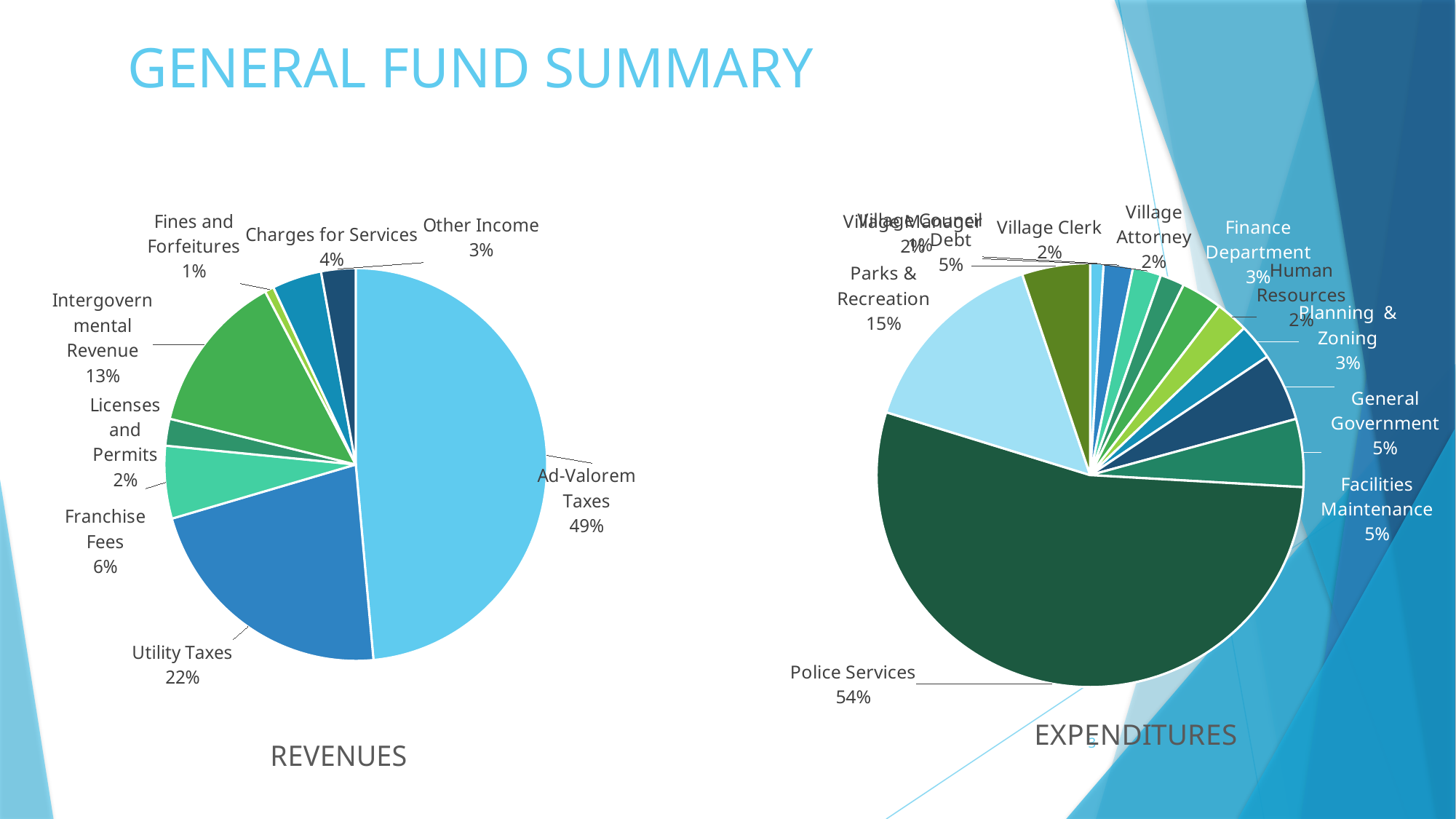
In the REVENUES pie chart, what is the difference between Utility Taxes and Franchise Fees? 16% In the REVENUES pie chart, what share is Intergovernmental Revenue? 13% In the REVENUES pie chart, what share is Ad-Valorem Taxes? 49% In the REVENUES pie chart, what share is Utility Taxes? 22% In the EXPENDITURES pie chart, what share is Parks & Recreation? 15% In the REVENUES pie chart, how many categories are shown? 8 In the EXPENDITURES pie chart, what share is Police Services? 54% In the EXPENDITURES pie chart, which is larger, General Government or Planning & Zoning? General Government In the REVENUES pie chart, which category has the smallest share? Fines and Forfeitures In the REVENUES pie chart, which category has the largest share? Ad-Valorem Taxes In the EXPENDITURES pie chart, which category has the largest share? Police Services What type of chart is used for REVENUES and EXPENDITURES on this slide? Pie chart